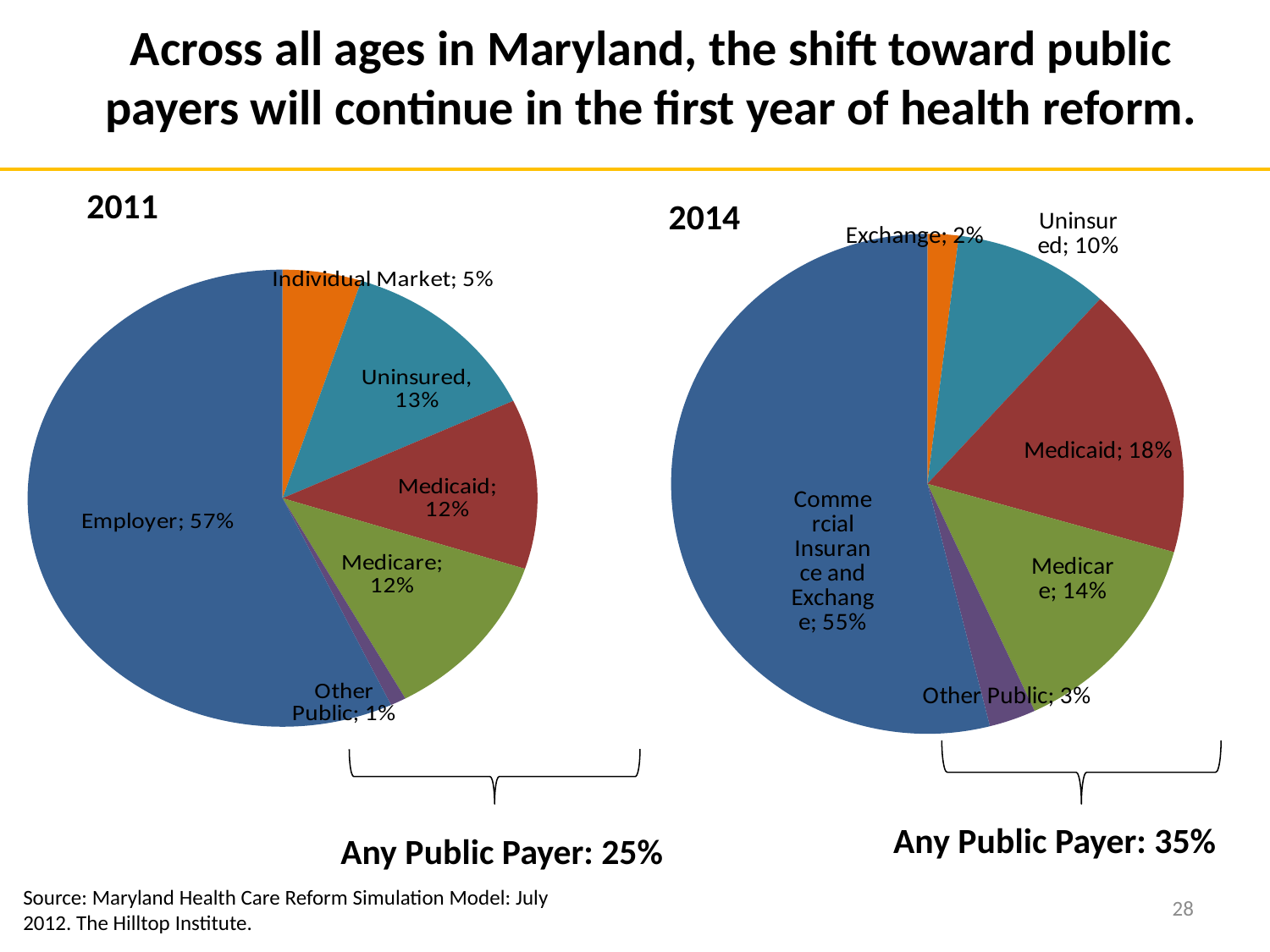
In the 2011 pie chart, which category has the smallest share? Other Public In the 2014 pie chart, which category has the largest share? Commercial Insurance and Exchange In the 2014 pie chart, what share does Other Public have? 3% In the 2014 pie chart, which category has the smallest share? Exchange What is the Any Public Payer figure shown under the 2014 pie chart? 35% What kind of charts are shown on the slide? Pie charts How many slices does the 2011 pie chart have? 6 In the 2014 pie chart, what share does Medicaid have? 18% In the 2011 pie chart, what share does Employer have? 57% In the 2011 pie chart, what share does Uninsured have? 13% Which is larger: the Uninsured share in 2011 or the Uninsured share in 2014? 2011 What is the difference between the Medicaid share in 2014 and the Medicaid share in 2011? 6 percentage points